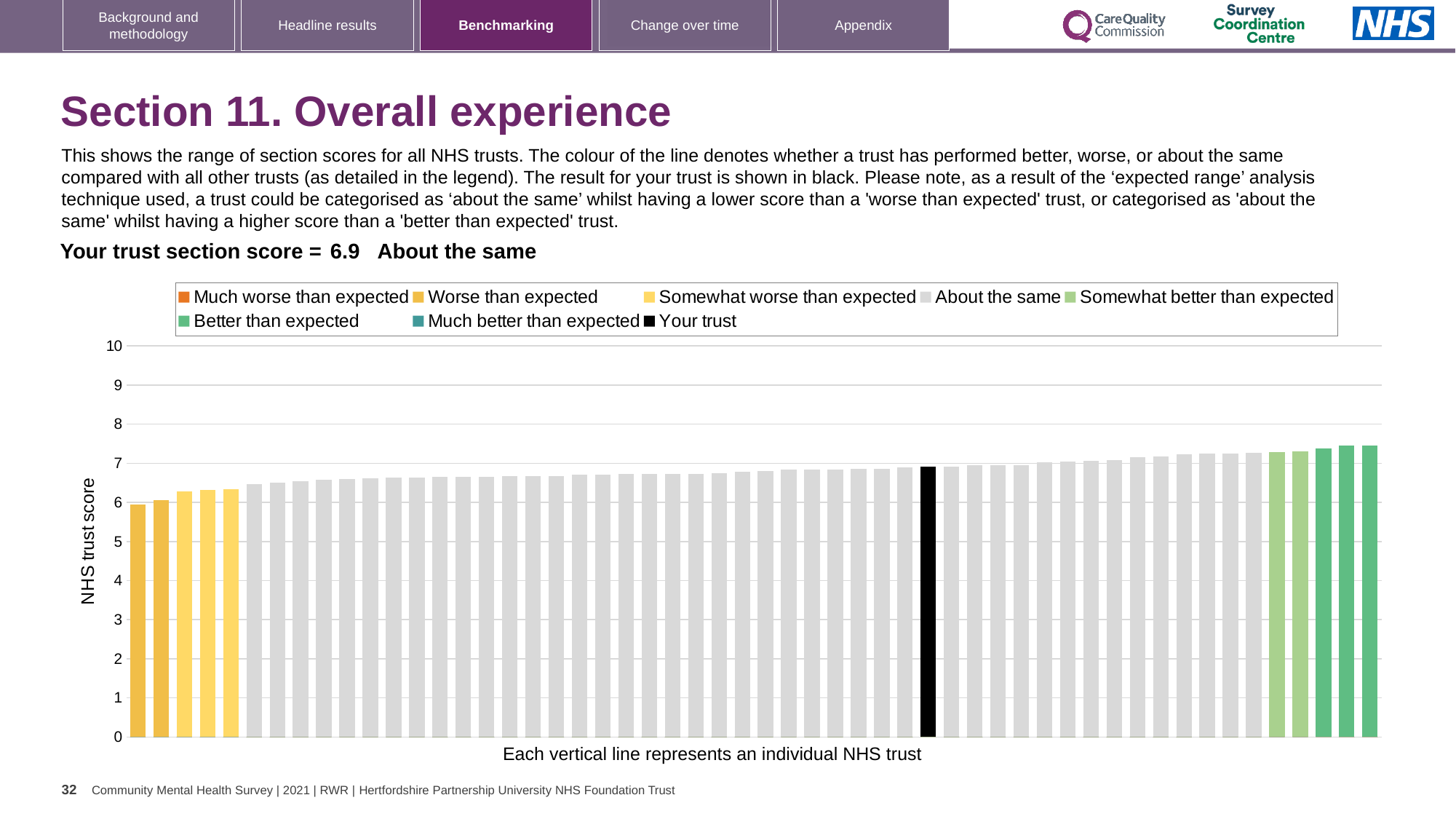
Which is larger, the leftmost bar or the rightmost bar? The rightmost bar What kind of chart is shown on the slide? Bar chart What is the label on the vertical axis of the chart? NHS trust score What colour is the bar representing your trust? Black Is the value of the tallest bar greater or less than 7? greater Is the value of the shortest bar greater or less than 7? less Is the value of the shortest bar greater or less than 5? greater Which benchmarking category is your trust placed in for this section? About the same How many entries does the chart legend list? 8 What is the section score for your trust shown on the slide? 6.9 Do the bar values rise or fall from left to right along the x axis? Rise